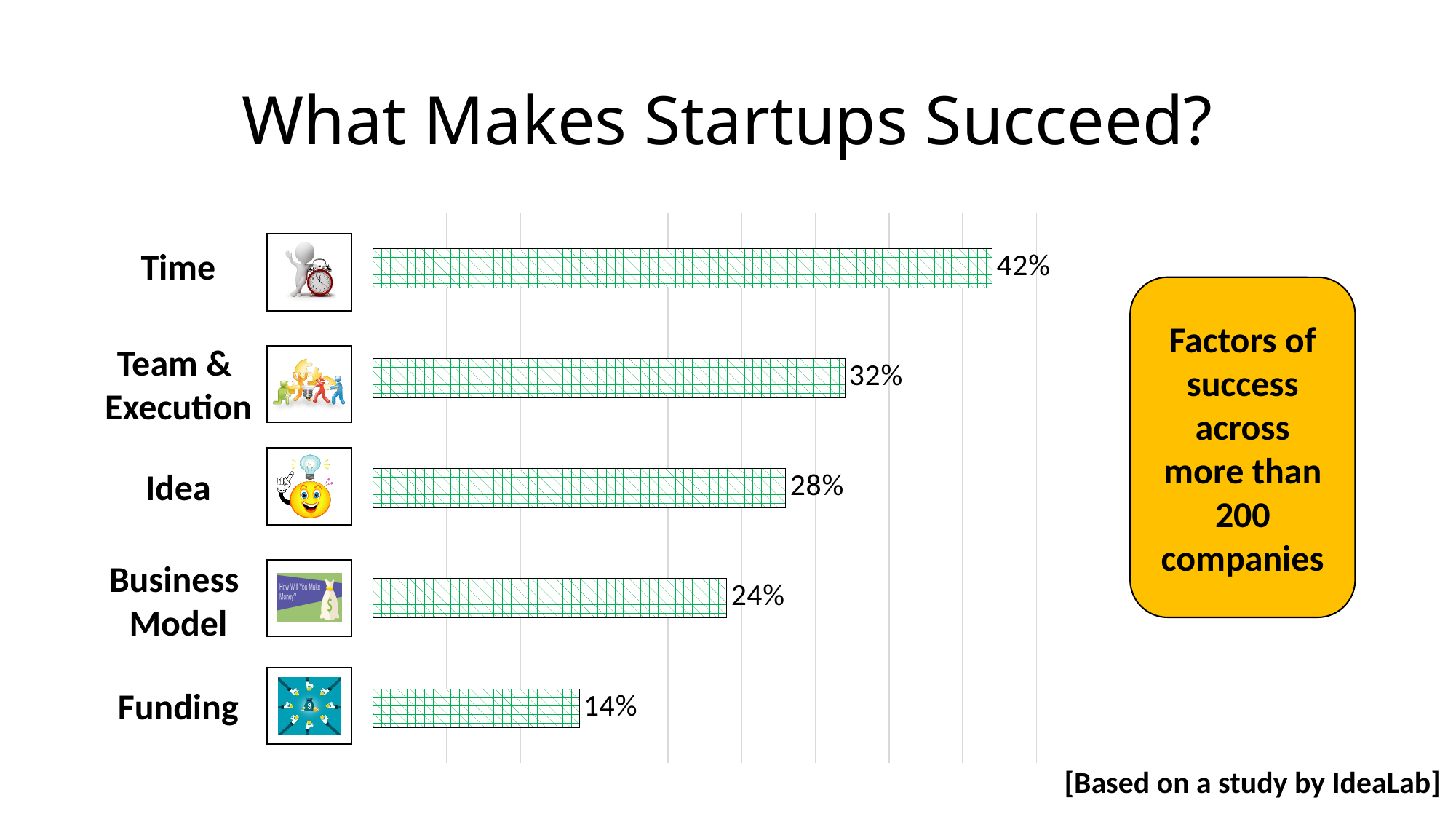
What percentage is shown for Business Model? 24% Which factor has the highest percentage? Time Which factor has the lowest percentage? Funding How many factors are shown in the chart? 5 What is the title of the slide? What Makes Startups Succeed? What percentage is shown for Time? 42% What kind of chart is shown on the slide? Bar chart What percentage is shown for Funding? 14% Which has a higher percentage, Idea or Business Model? Idea What percentage is shown for Team & Execution? 32% What is the difference between the percentages for Time and Funding? 28% What is the difference between the percentages for Team & Execution and Idea? 4%